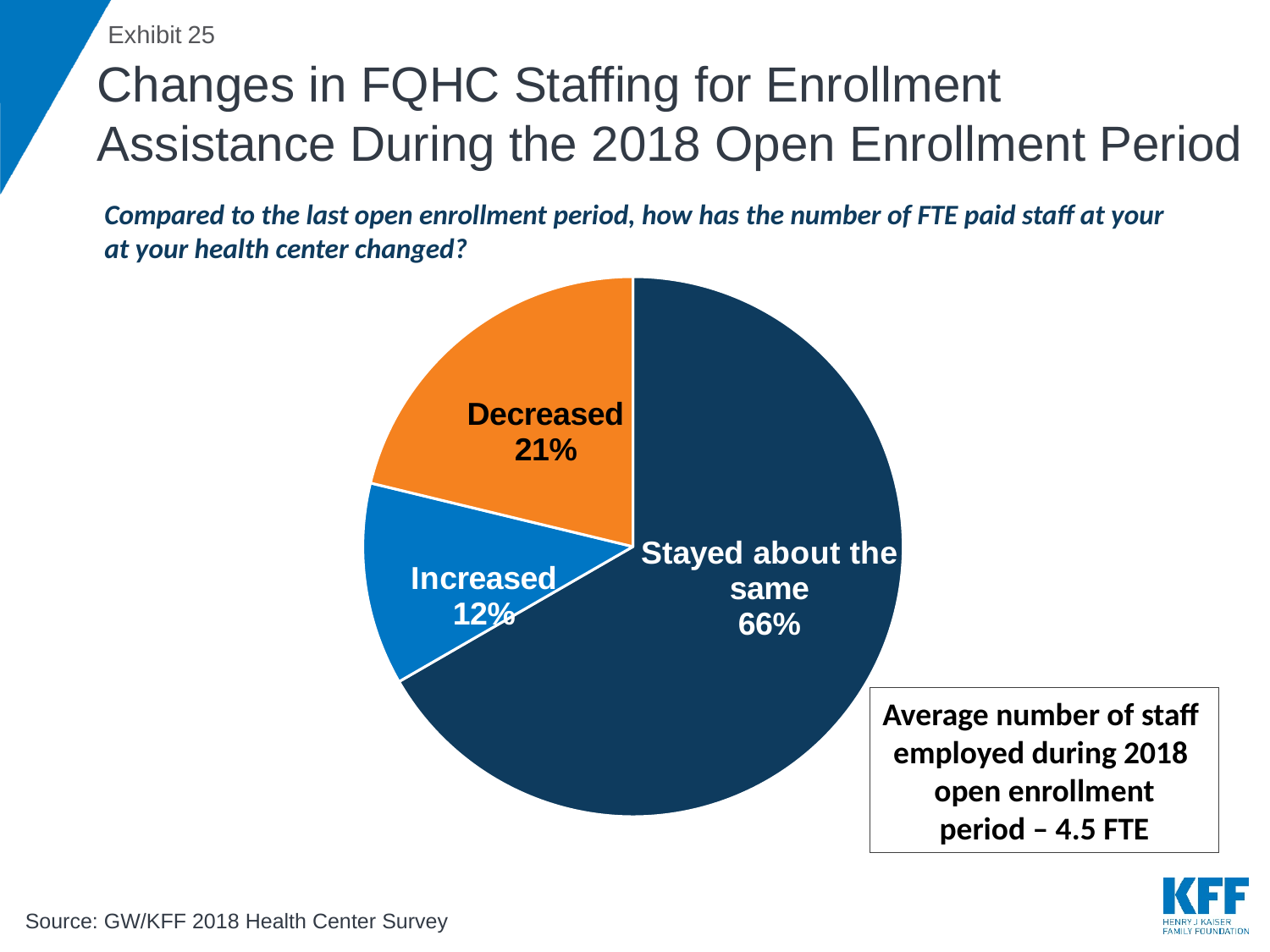
What colour is the 'Decreased' slice of the pie? Orange What is the difference in percentage points between 'Stayed about the same' and 'Decreased'? 45 percentage points What percentage of health centers reported that staffing stayed about the same? 66% Which response category has the largest share of the pie? Stayed about the same What percentage of health centers reported that staffing decreased? 21% What is the difference in percentage points between 'Decreased' and 'Increased'? 9 percentage points How many categories are shown in the pie chart? 3 What percentage of health centers reported that staffing increased? 12% According to the text box on the slide, what was the average number of staff employed during the 2018 open enrollment period? 4.5 FTE Which response category has the smallest share of the pie? Increased Which is larger, the share for 'Decreased' or the share for 'Increased'? Decreased What type of chart is shown on the slide? Pie chart